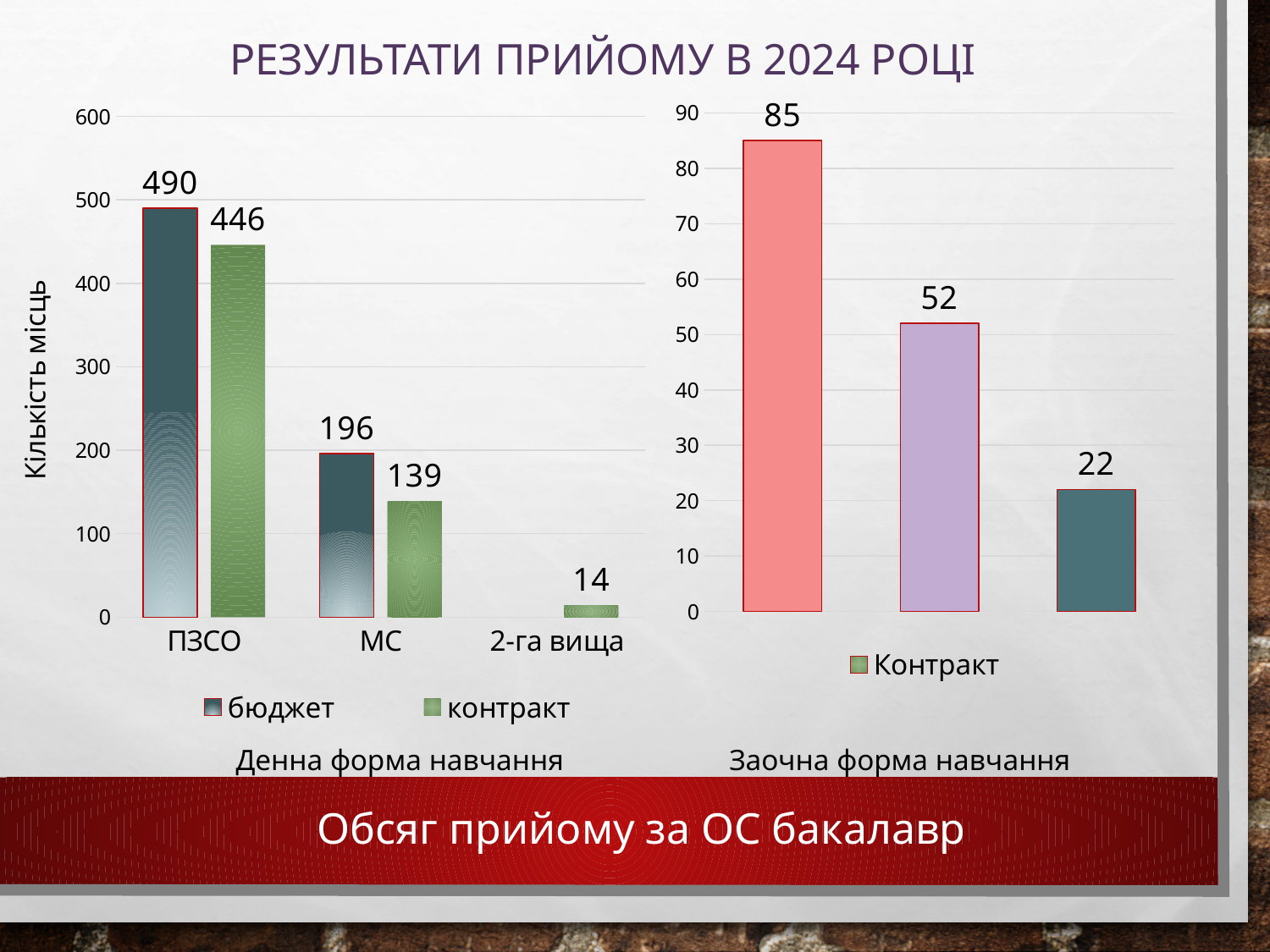
In the right chart (Заочна форма навчання), what is the value of the shortest bar? 22 In the left chart (Денна форма навчання), how many categories are shown on the x axis? 3 In the left chart (Денна форма навчання), how many series does the legend list? 2 In the left chart (Денна форма навчання), which category has the lowest контракт value? 2-га вища In the left chart (Денна форма навчання), what is the контракт value for МС? 139 In the left chart (Денна форма навчання), what is the бюджет value for ПЗСО? 490 What kind of chart is the right chart (Заочна форма навчання)? bar chart In the right chart (Заочна форма навчання), what is the value of the tallest bar? 85 In the left chart (Денна форма навчання), what is the контракт value for 2-га вища? 14 In the left chart (Денна форма навчання), what is the difference between the бюджет and контракт values for ПЗСО? 44 In the left chart (Денна форма навчання), which category has the highest бюджет value? ПЗСО In the left chart (Денна форма навчання), which is larger for МС: бюджет or контракт? бюджет